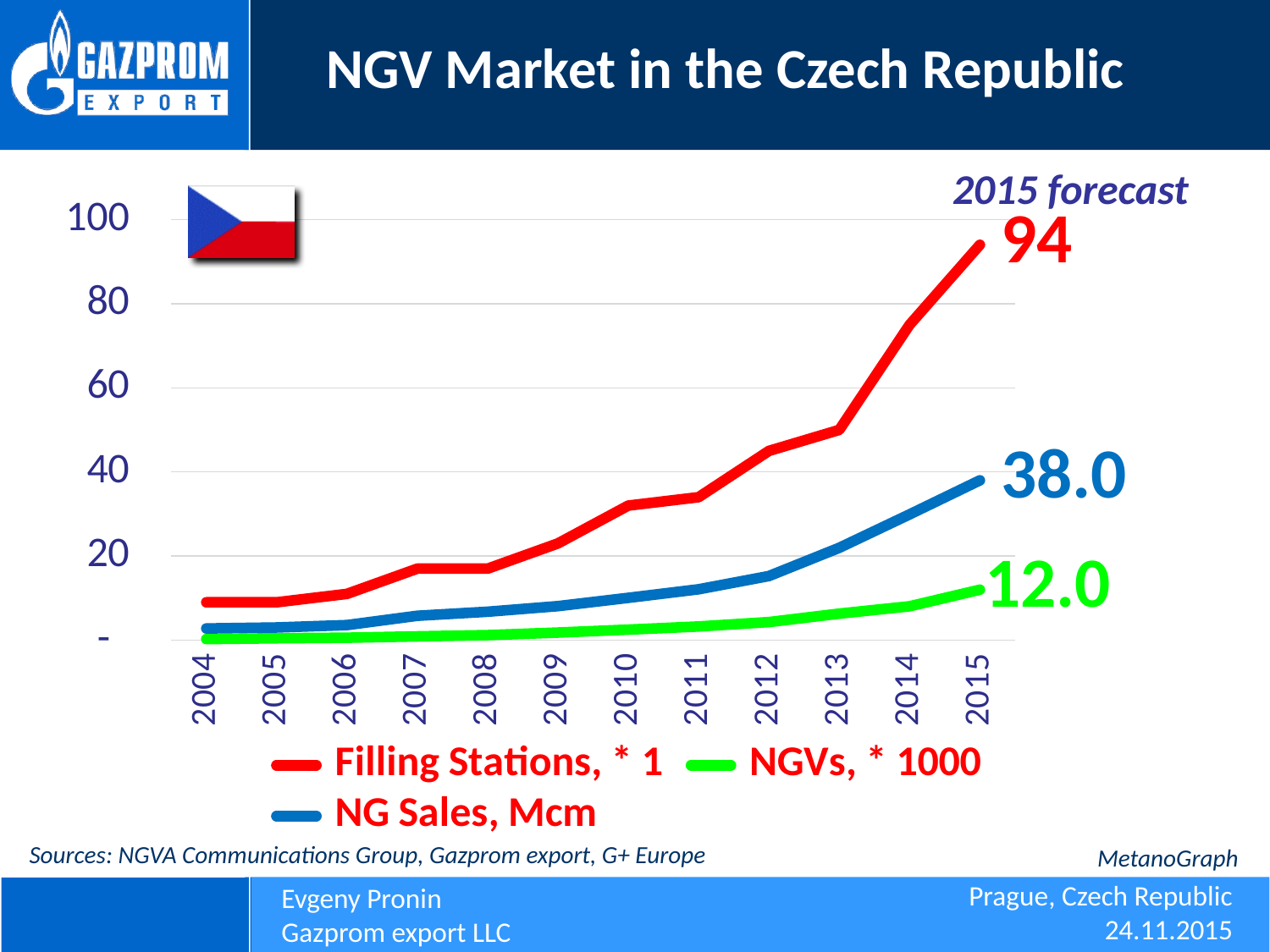
Which series has the lowest value in 2015? NGVs, * 1000 Is the value for Filling Stations in 2013 greater or less than 40? greater How many years are shown on the x axis? 12 How many series does the legend list? 3 Which series has the highest value in 2015? Filling Stations, * 1 What is the difference between the 2015 values for NG Sales, Mcm and NGVs, * 1000? 26.0 What kind of chart is shown on the slide? line chart In 2015, which is larger: Filling Stations or NG Sales? Filling Stations What is the 2015 forecast value for Filling Stations? 94 Is the value for NG Sales, Mcm in 2012 greater or less than 20? less What is the 2015 forecast value for NG Sales, Mcm? 38.0 What is the 2015 forecast value for NGVs, * 1000? 12.0